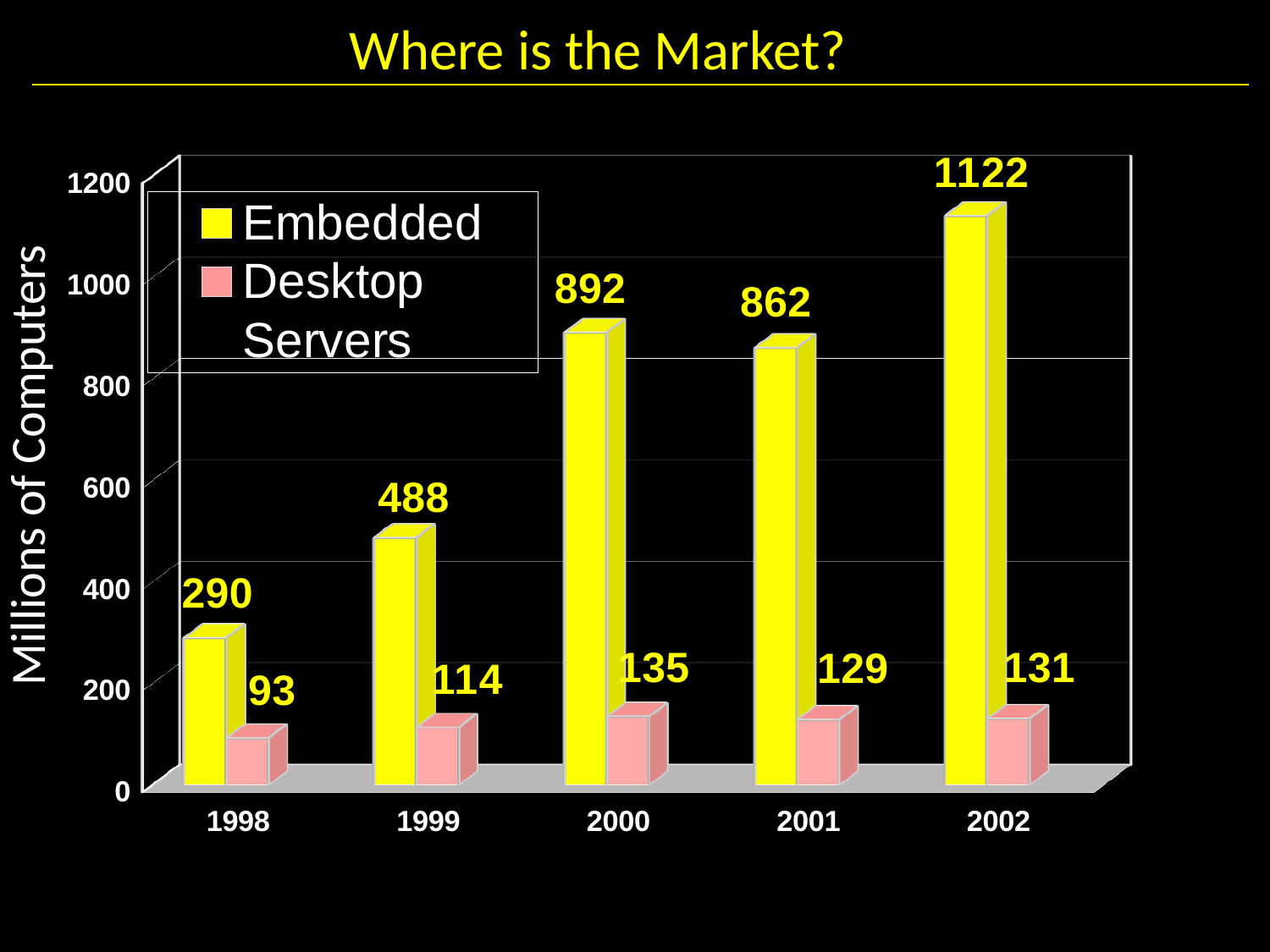
What is the Embedded value for 2002? 1122 What is the label of the vertical axis? Millions of Computers What kind of chart is shown on the slide? bar chart What is the Embedded value for 2000? 892 Which year has the highest Embedded value? 2002 Which is larger, the Embedded value for 1999 or the Embedded value for 2001? 2001 How many series does the legend list? 3 Is the Embedded value for 2002 greater or less than 1000? greater How many years are shown on the x axis? 5